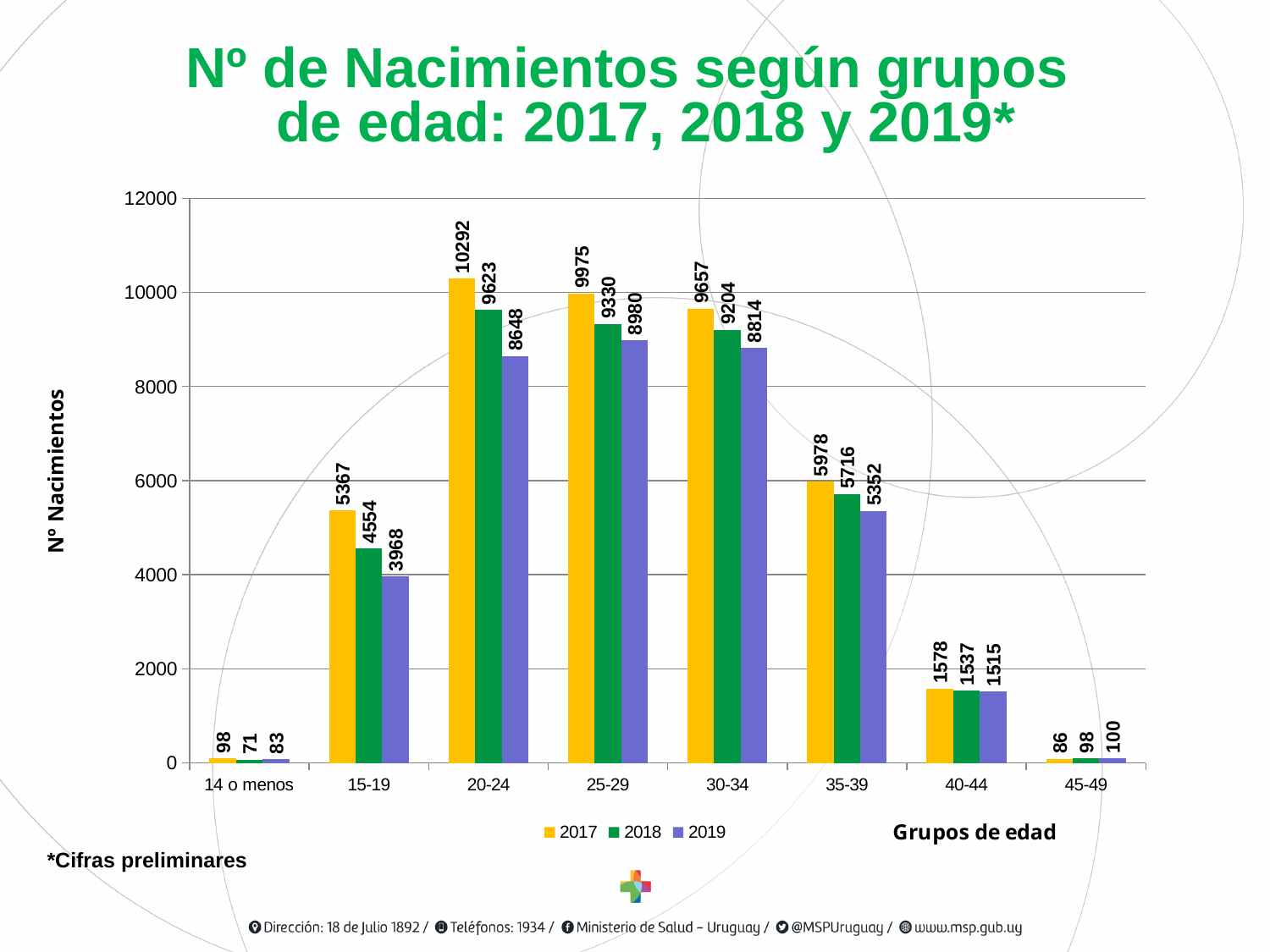
Is the 2018 value for the 30-34 age group greater or less than 10000? less What is the number of births for the 35-39 age group in 2019? 5352 Which is larger: the 2019 value for 25-29 or the 2019 value for 30-34? 25-29 Which age group has the lowest number of births in 2017? 45-49 What is the number of births for the 20-24 age group in 2017? 10292 What is the number of births for the 45-49 age group in 2018? 98 What is the difference between the 2017 and 2019 values for the 15-19 age group? 1399 Which age group has the highest number of births in 2018? 20-24 What kind of chart is shown on the slide? bar chart How many age groups are shown on the x axis? 8 How many series does the legend list? 3 Which colour represents the 2019 series in the legend? purple